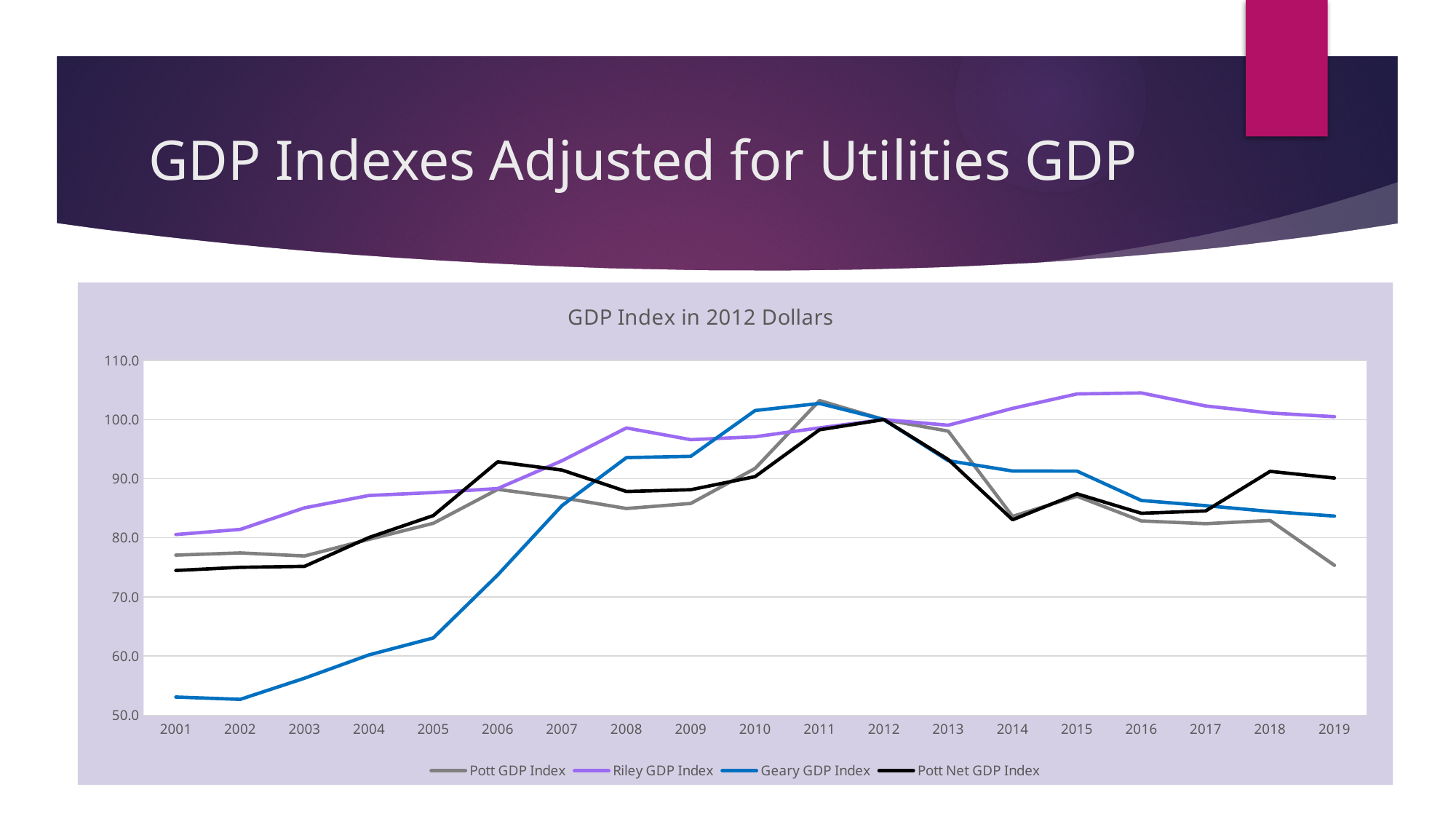
How many series does the legend list? 4 What kind of chart is shown on the slide? line chart Is the value for Pott Net GDP Index in 2006 greater or less than 90? greater How many years are plotted along the x axis? 19 Which series is drawn in blue? Geary GDP Index In 2005, which is larger: Geary GDP Index or Pott Net GDP Index? Pott Net GDP Index What is the title of the chart? GDP Index in 2012 Dollars Which series has the highest value in 2019? Riley GDP Index Is the value for Riley GDP Index in 2015 greater or less than 100? greater Is the value for Pott GDP Index in 2019 greater or less than 80? less Which series has the lowest value in 2001? Geary GDP Index